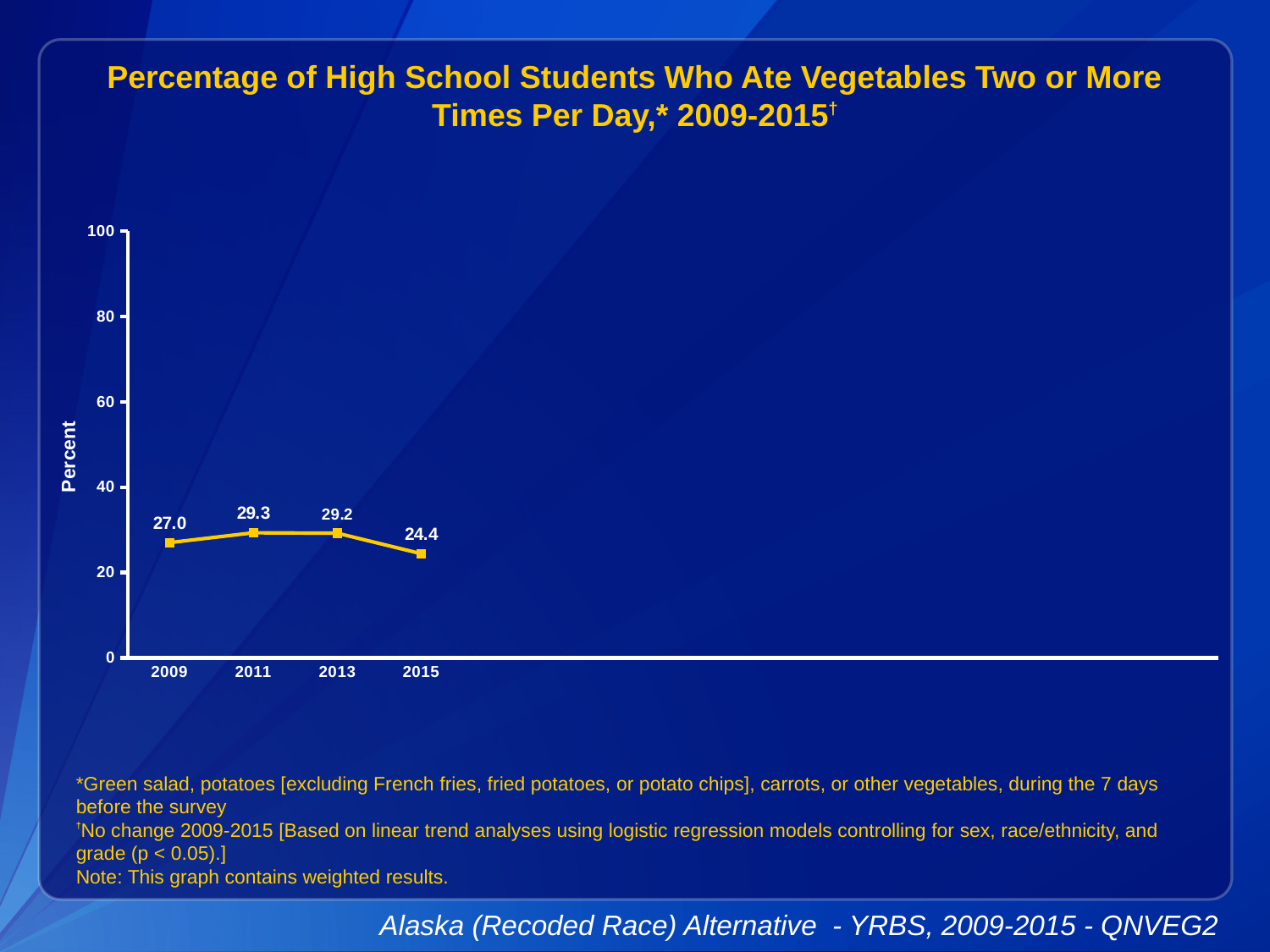
Which is larger, the value for 2009 or the value for 2015? 2009 What is the label on the y axis? Percent What is the value plotted for 2015? 24.4 What is the difference between the 2011 value and the 2015 value? 4.9 Is the value for 2011 greater or less than 40? less How many years are plotted on the chart? 4 What kind of chart is shown on the slide? line chart Which year has the lowest percentage? 2015 What percentage of high school students ate vegetables two or more times per day in 2009? 27.0 Does the value rise or fall from 2013 to 2015? fall What is the value plotted for 2013? 29.2 Which year has the highest percentage? 2011